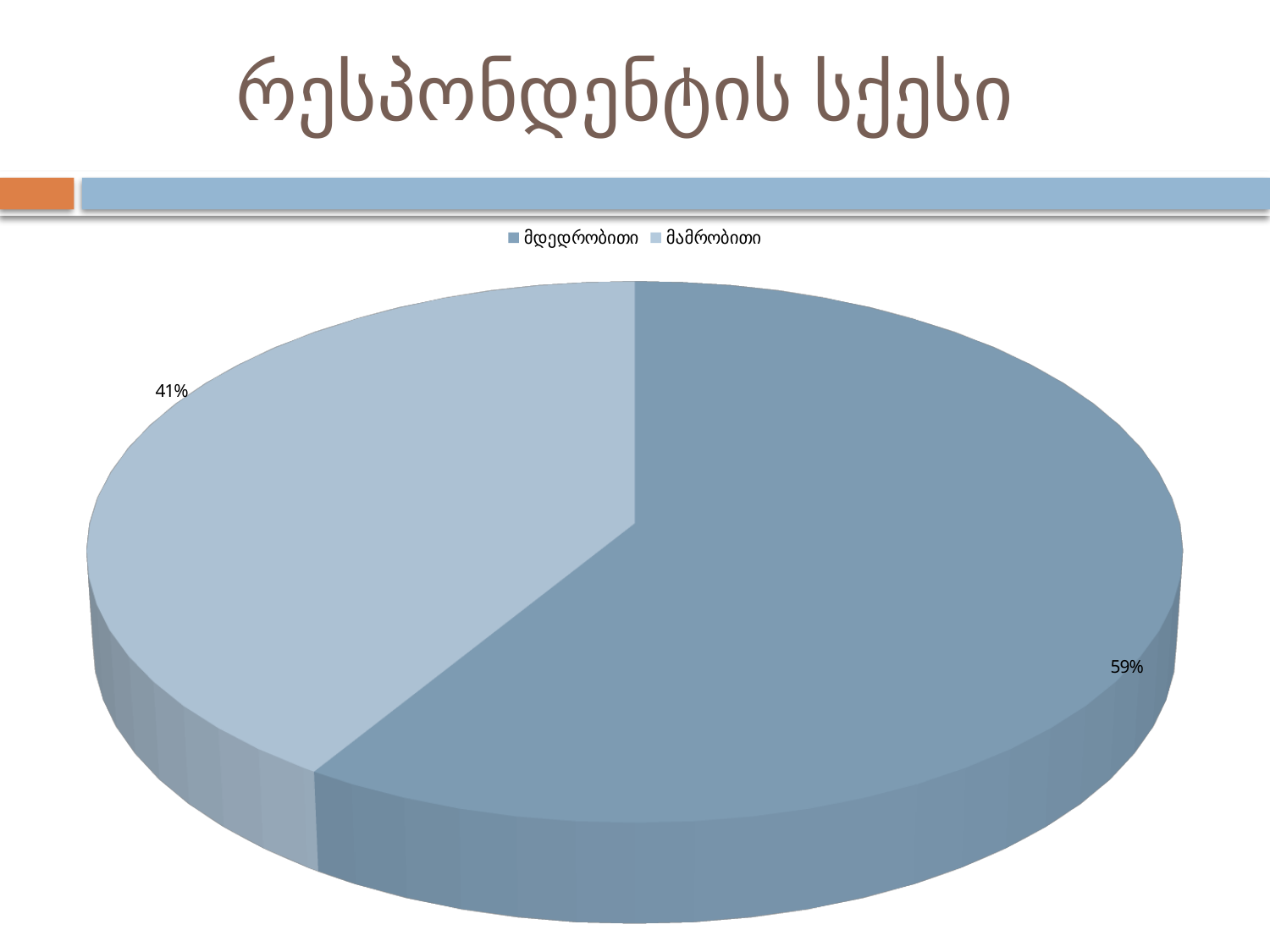
What kind of chart is shown on the slide? pie chart Which category has the smallest slice of the pie? მამრობითი Which category has the largest slice of the pie? მდედრობითი What share of the pie is labelled მდედრობითი? 59% What share of the pie is labelled მამრობითი? 41% Is the share for მამრობითი greater or less than 50%? less Which slice is larger, მდედრობითი or მამრობითი? მდედრობითი How many slices does the pie chart have? 2 What is the title of the chart on the slide? რესპონდენტის სქესი How many entries does the legend list? 2 Which legend entry is shown in the lighter blue colour? მამრობითი What is the difference in percentage points between the მდედრობითი and მამრობითი slices? 18